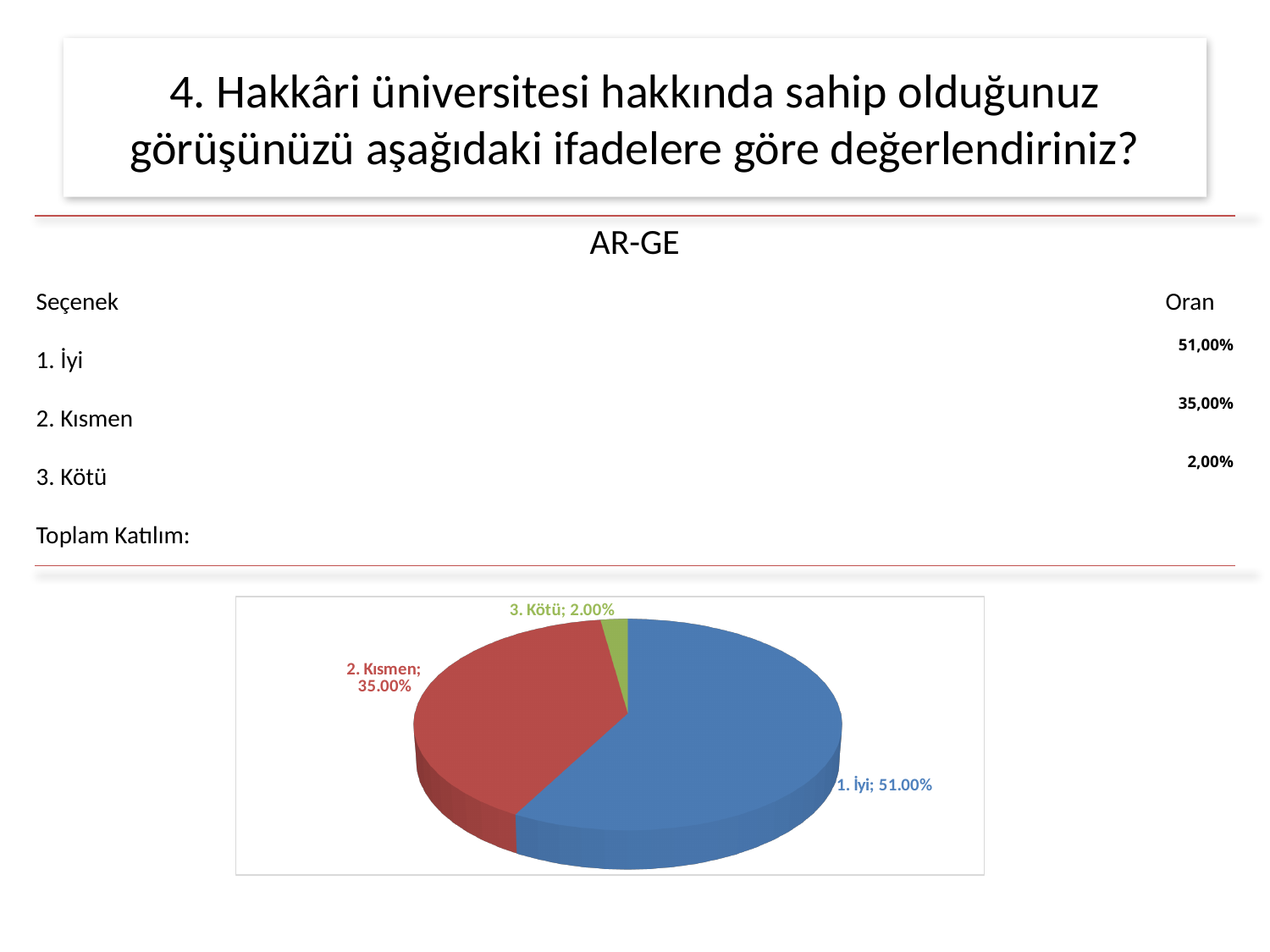
What kind of chart is shown on the slide? pie chart Which is larger in the pie chart, the value for "2. Kısmen" or the value for "3. Kötü"? 2. Kısmen What is the value shown for the slice labelled "1. İyi" in the pie chart? 51.00% What is the value shown for the slice labelled "3. Kötü" in the pie chart? 2.00% What colour is the slice for "3. Kötü" in the pie chart? green Which slice of the pie chart is the smallest? 3. Kötü What is the difference between the values for "2. Kısmen" and "3. Kötü" in the pie chart? 33.00% What is the difference between the values for "1. İyi" and "2. Kısmen" in the pie chart? 16.00% Which slice of the pie chart is the largest? 1. İyi What is the value shown for the slice labelled "2. Kısmen" in the pie chart? 35.00% What colour is the slice for "1. İyi" in the pie chart? blue How many slices does the pie chart have? 3